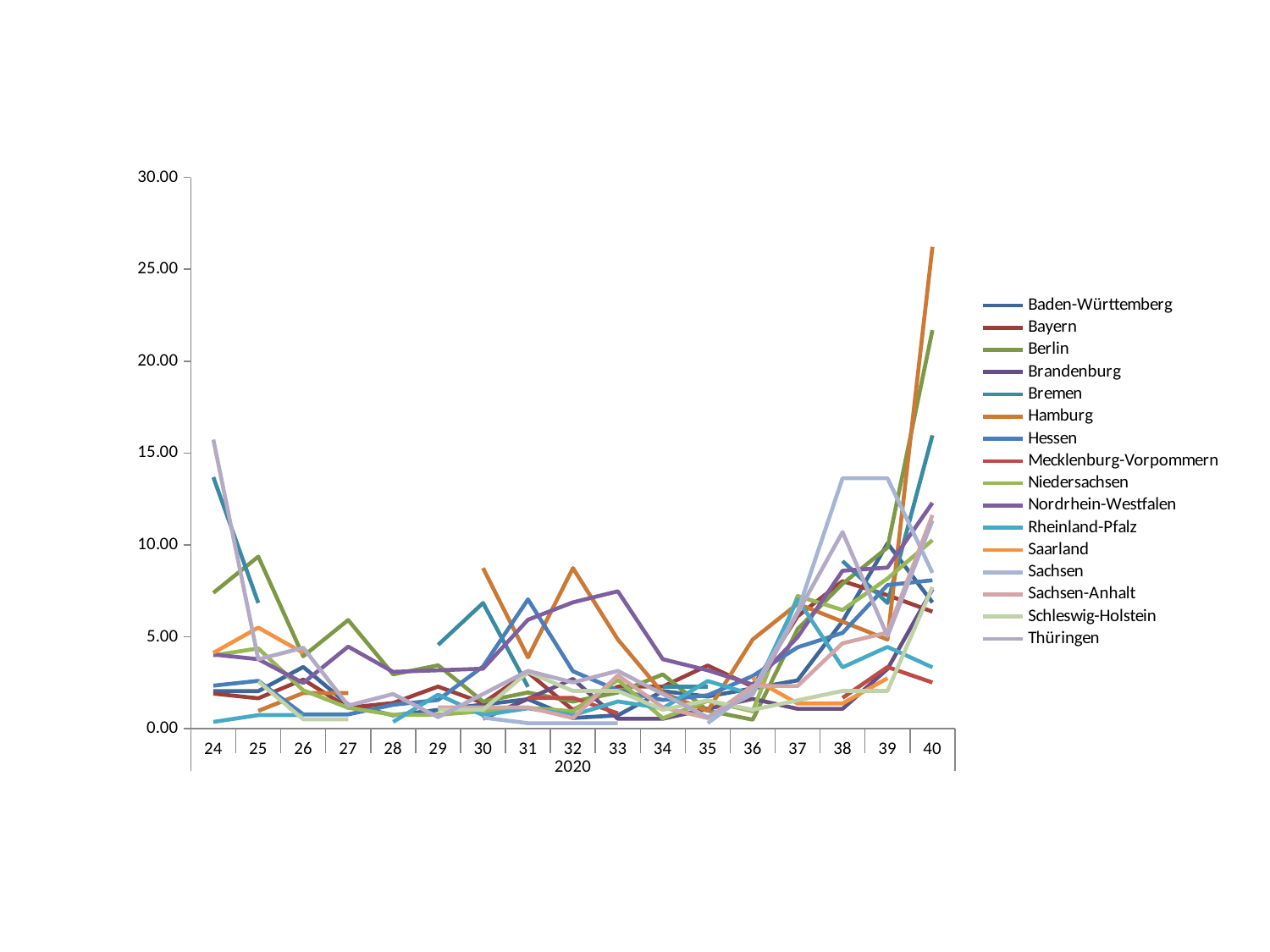
Which series has the highest value at week 40? Hamburg Is the value for Hamburg at week 40 greater or less than 20? greater How many week values are shown along the x axis? 17 What kind of chart is shown on the slide? line chart At week 24, which is larger, the value for Thüringen or the value for Bremen? Thüringen Is the value for Berlin at week 40 greater or less than 20? greater At week 40, which is larger, the value for Hamburg or the value for Berlin? Hamburg Is the value for Thüringen at week 24 greater or less than 10? greater What year is labelled below the x axis? 2020 How many series does the legend list? 16 Does the value for Hamburg rise or fall from week 36 to week 40? rise